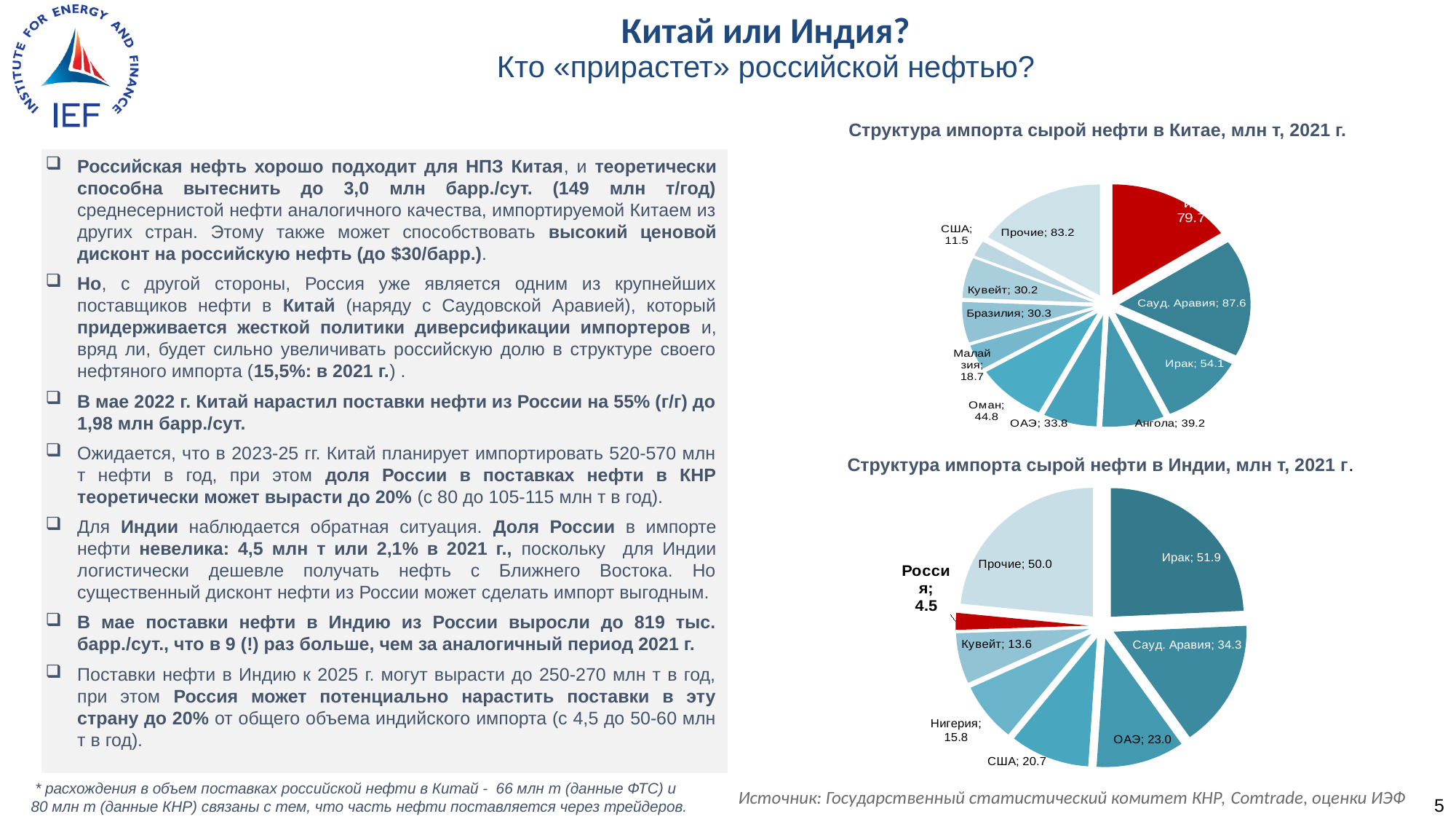
On the chart 'Структура импорта сырой нефти в Китае, млн т, 2021 г.', which slice has the largest value? Сауд. Аравия On the chart 'Структура импорта сырой нефти в Индии, млн т, 2021 г.', which slice has the smallest value? Россия On the chart 'Структура импорта сырой нефти в Китае, млн т, 2021 г.', which slice has the smallest value? США On the chart 'Структура импорта сырой нефти в Китае, млн т, 2021 г.', what is the value for Ирак? 54.1 On the chart 'Структура импорта сырой нефти в Индии, млн т, 2021 г.', what is the value for Россия? 4.5 What type of chart is 'Структура импорта сырой нефти в Индии, млн т, 2021 г.'? Pie chart On the chart 'Структура импорта сырой нефти в Индии, млн т, 2021 г.', what is the difference between the values for Сауд. Аравия and ОАЭ? 11.3 On the chart 'Структура импорта сырой нефти в Индии, млн т, 2021 г.', which is larger: Кувейт or Нигерия? Нигерия On the chart 'Структура импорта сырой нефти в Индии, млн т, 2021 г.', what is the value for Ирак? 51.9 On the chart 'Структура импорта сырой нефти в Китае, млн т, 2021 г.', how many slices does the pie have? 11 On the chart 'Структура импорта сырой нефти в Китае, млн т, 2021 г.', what is the value for Сауд. Аравия? 87.6 On the chart 'Структура импорта сырой нефти в Китае, млн т, 2021 г.', what is the difference between the values for Оман and Ангола? 5.6